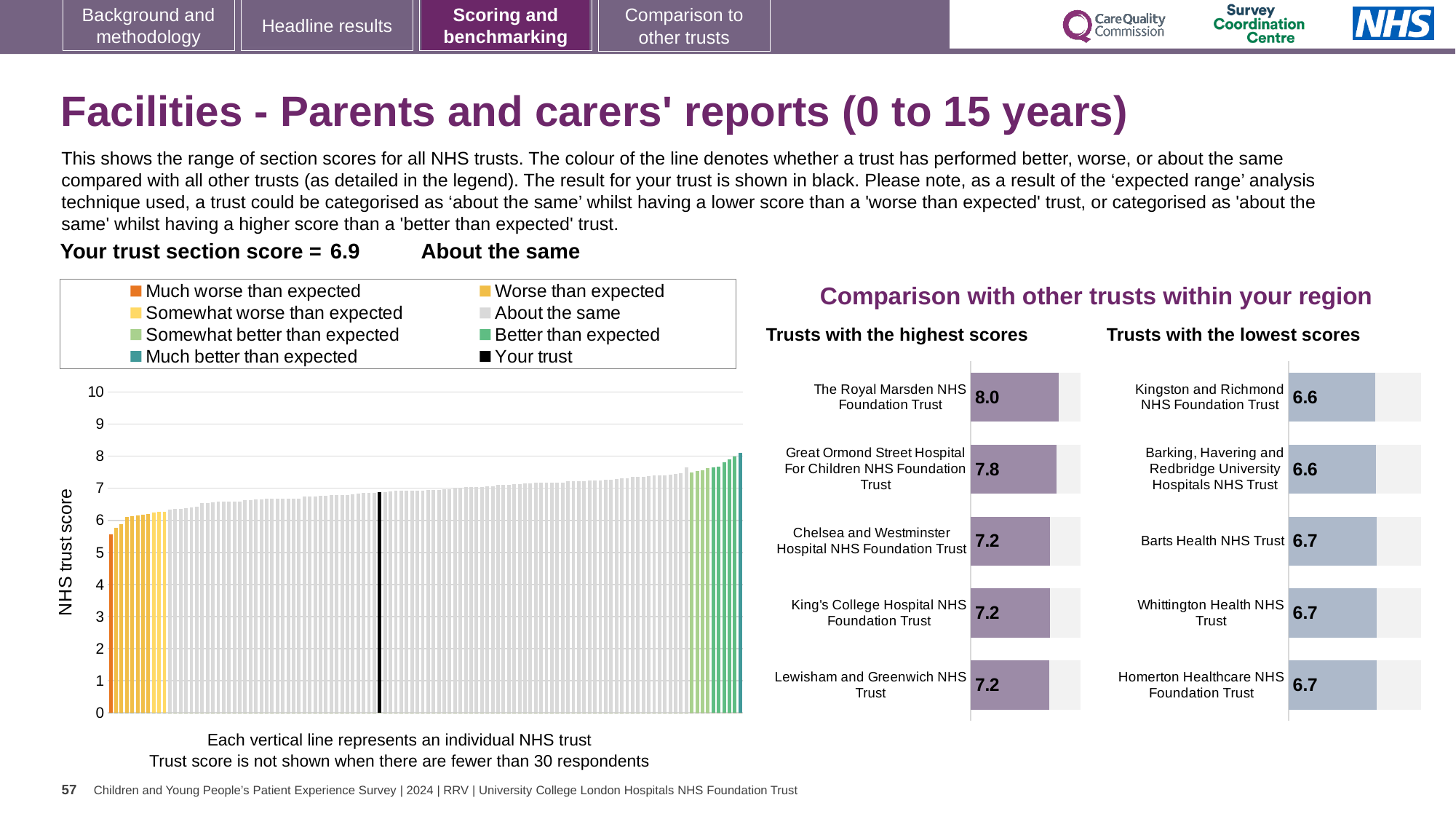
In the large chart on the left, is the value of the highest (rightmost) bar greater or less than 7? greater In the 'Trusts with the highest scores' chart, which trust has the highest score? The Royal Marsden NHS Foundation Trust In the large chart on the left, what is the label on the vertical axis? NHS trust score In the 'Trusts with the lowest scores' chart, how many trusts are shown? 5 In the large chart on the left, do the trust scores rise or fall from left to right? Rise What kind of chart is the large chart on the left showing NHS trust scores? Bar chart How many entries does the legend above the large chart on the left list? 8 In the 'Trusts with the highest scores' chart, what is the score for The Royal Marsden NHS Foundation Trust? 8.0 In the 'Trusts with the highest scores' chart, what is the difference between the scores of The Royal Marsden NHS Foundation Trust and Great Ormond Street Hospital For Children NHS Foundation Trust? 0.2 According to the slide, what is your trust's section score for Facilities? 6.9 In the large chart on the left, is the value of the lowest (leftmost) bar greater or less than 6? less In the 'Trusts with the lowest scores' chart, which has the higher score: Barts Health NHS Trust or Kingston and Richmond NHS Foundation Trust? Barts Health NHS Trust